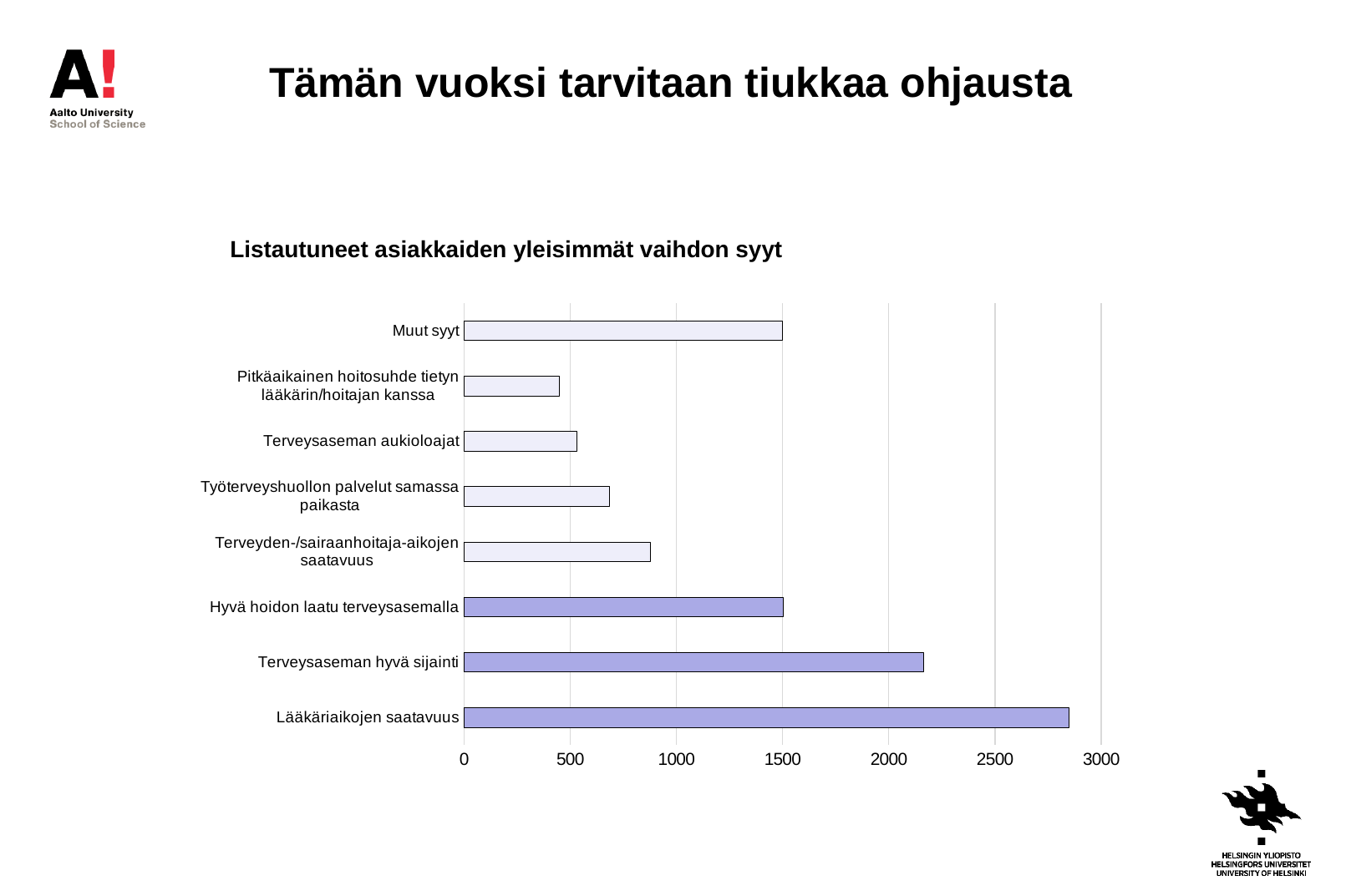
Which category has the highest value? Lääkäriaikojen saatavuus Is the value for Terveyden-/sairaanhoitaja-aikojen saatavuus greater or less than 1000? less How many categories are plotted in the chart? 8 Which is larger, the value for Terveysaseman hyvä sijainti or the value for Hyvä hoidon laatu terveysasemalla? Terveysaseman hyvä sijainti What is the title of the chart? Listautuneet asiakkaiden yleisimmät vaihdon syyt Which is larger, the value for Työterveyshuollon palvelut samassa paikasta or the value for Muut syyt? Muut syyt What kind of chart is shown on the slide? bar chart Which category has the lowest value? Pitkäaikainen hoitosuhde tietyn lääkärin/hoitajan kanssa Is the value for Terveysaseman aukioloajat greater or less than 1000? less Is the value for Terveysaseman hyvä sijainti greater or less than 2000? greater